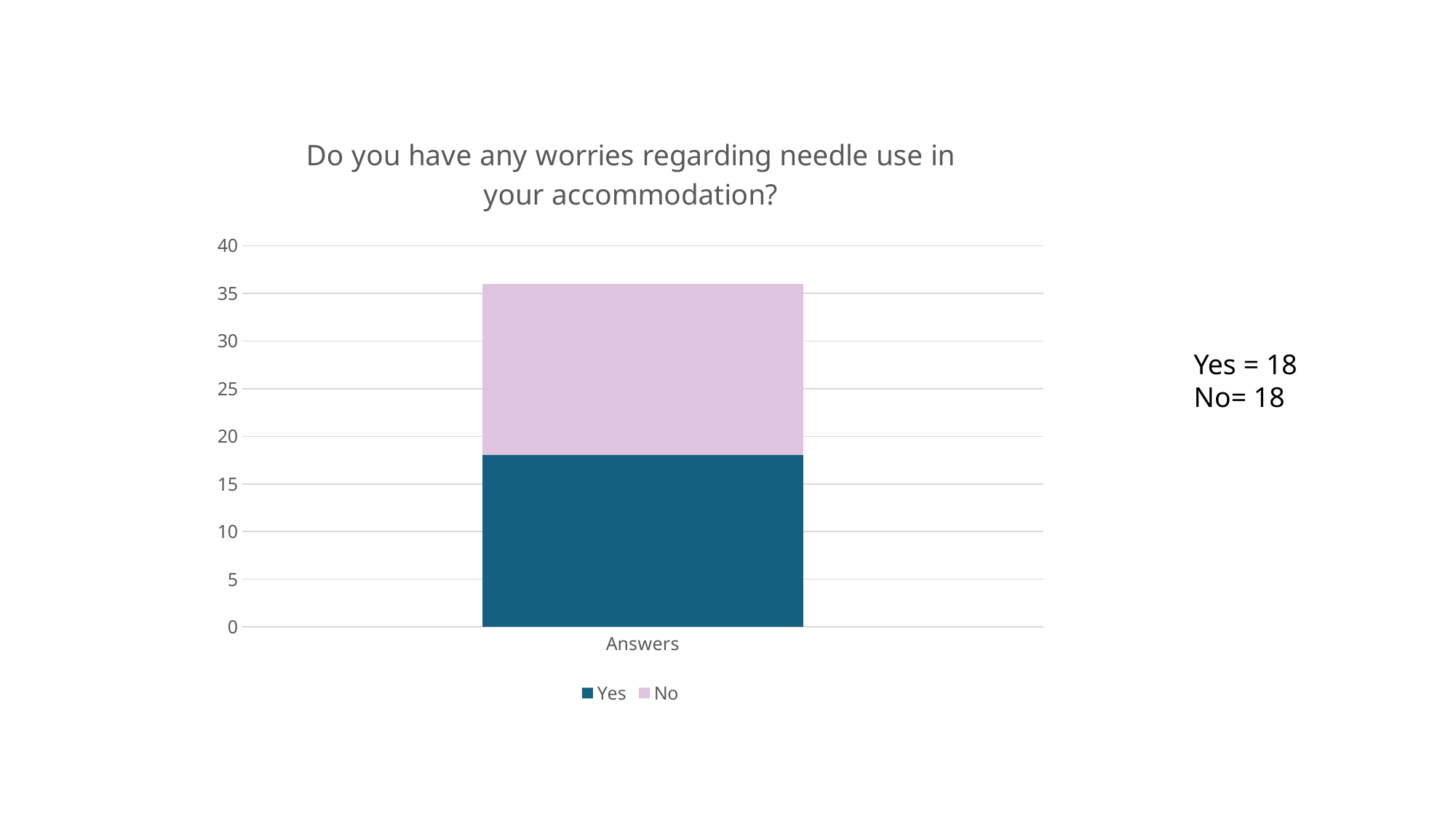
What is the difference between the Yes and No values? 0 What is the value for No? 18 What kind of chart is shown on the slide? bar chart What is the total of the stacked bar for Answers? 36 What is the title of the chart? Do you have any worries regarding needle use in your accommodation? Is the total height of the Answers bar greater or less than 30? greater What is the label of the category on the x axis? Answers How many categories are shown on the x axis? 1 How many series does the legend list? 2 Is the value for Yes greater or less than 20? less What are the series listed in the legend? Yes, No What is the value for Yes? 18